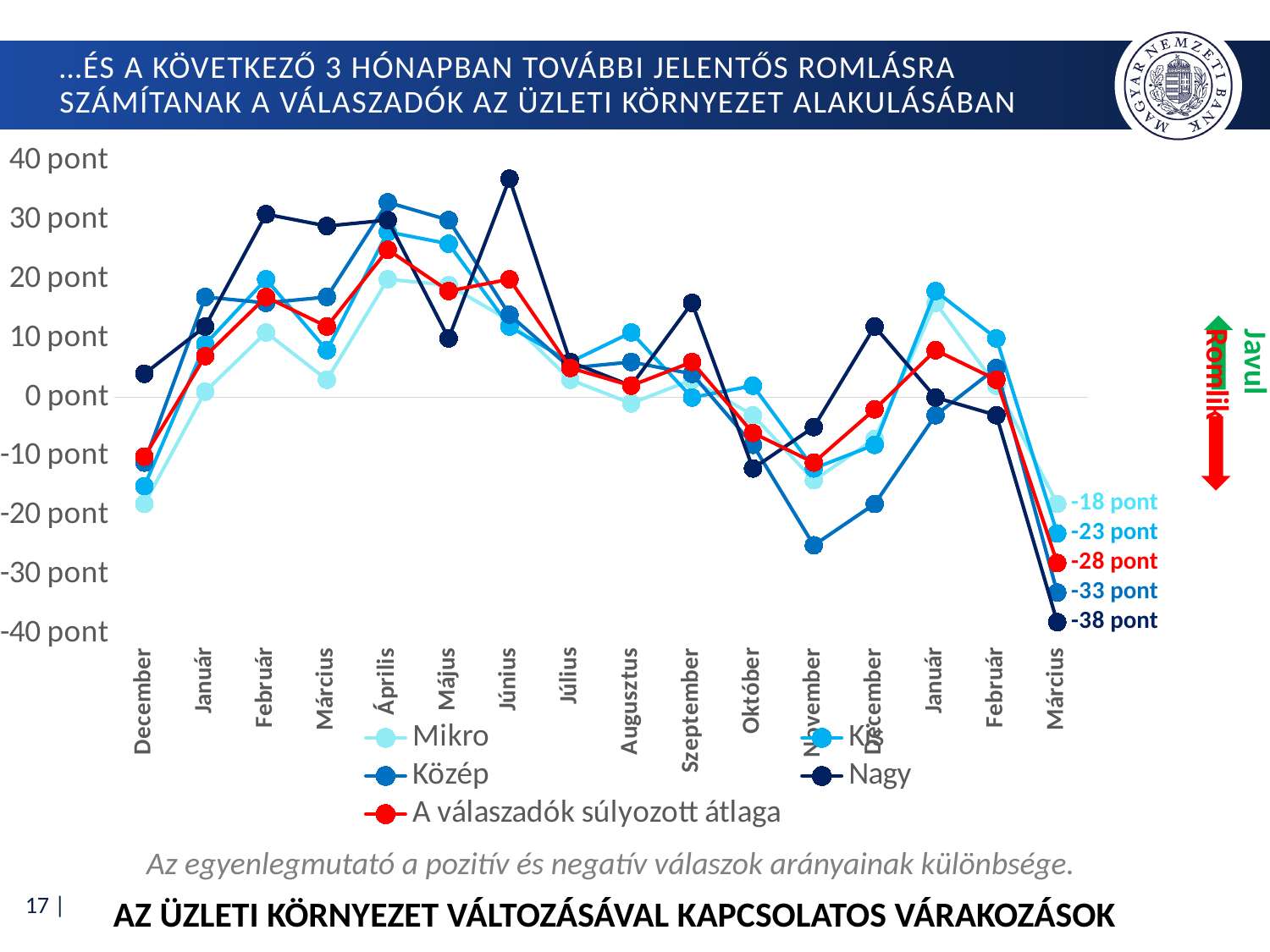
How many months are shown along the x axis? 16 What is the value for Nagy in the final Március? -38 pont Is the value for Nagy in Június greater or less than 30 pont? greater What type of chart is shown on the slide? line chart Is the value for Közép in November greater or less than -20 pont? less How many series does the legend list? 5 Which series has the lowest value in the final Március? Nagy What is the value of 'A válaszadók súlyozott átlaga' in the final Március? -28 pont Which series has the highest value in the final Március? Mikro What is the difference between the Mikro and Nagy values in the final Március? 20 pont What is the value for Közép in the final Március? -33 pont What is the value for Mikro in the final Március? -18 pont